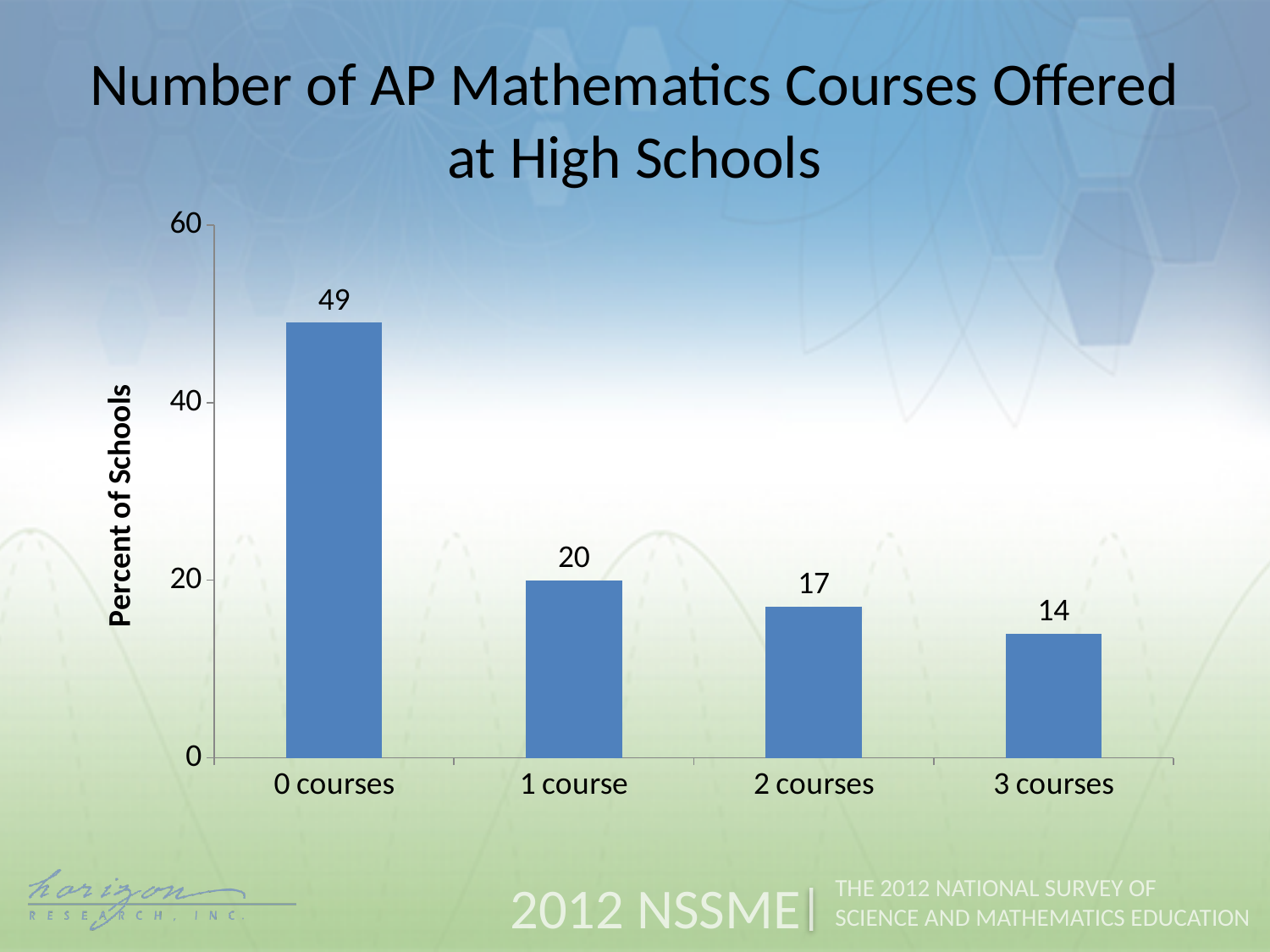
What is the difference between the values for 0 courses and 1 course? 29 Which category has the lowest percent of schools? 3 courses What is the value for 1 course? 20 What percent of schools offer 0 AP mathematics courses? 49 Do the values rise or fall from 0 courses to 3 courses? fall Which is larger, the value for 2 courses or the value for 3 courses? 2 courses Is the value for 0 courses greater or less than 40? greater What kind of chart is shown on the slide? bar chart What is the value for 3 courses? 14 How many categories are shown on the x axis? 4 What is the value for 2 courses? 17 Which category has the highest percent of schools? 0 courses